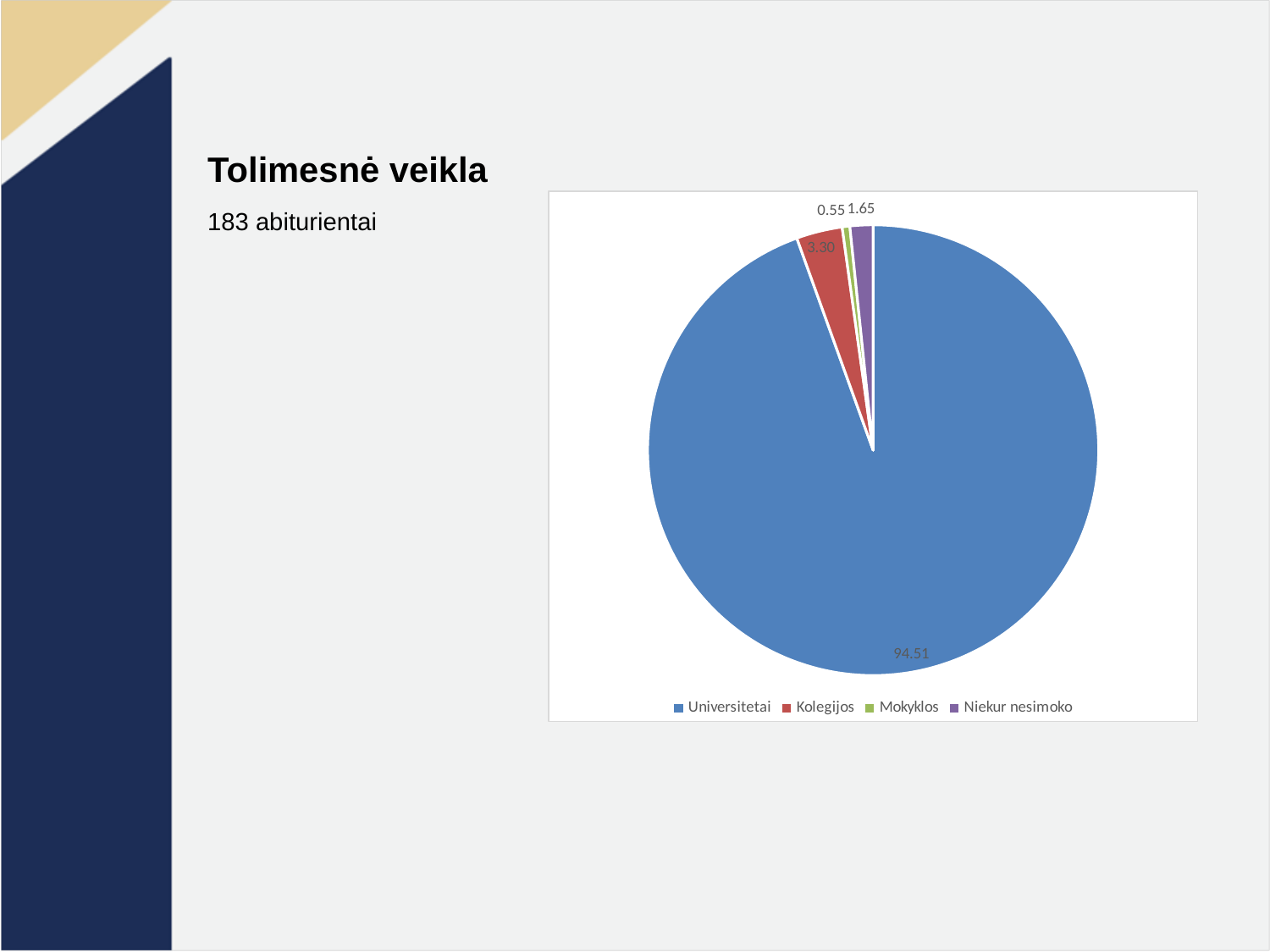
What kind of chart is shown on the slide? pie chart How many slices does the pie chart have? 4 Which category has the smallest slice of the pie? Mokyklos Which is larger, the value for Niekur nesimoko or the value for Mokyklos? Niekur nesimoko What is the difference between the values for Kolegijos and Niekur nesimoko? 1.65 What is the value shown for Mokyklos? 0.55 What is the value shown for Niekur nesimoko? 1.65 What is the value shown for Kolegijos? 3.30 Which category has the largest slice of the pie? Universitetai What colour is the Kolegijos slice? red What is the value shown for Universitetai? 94.51 How many entries does the legend list? 4